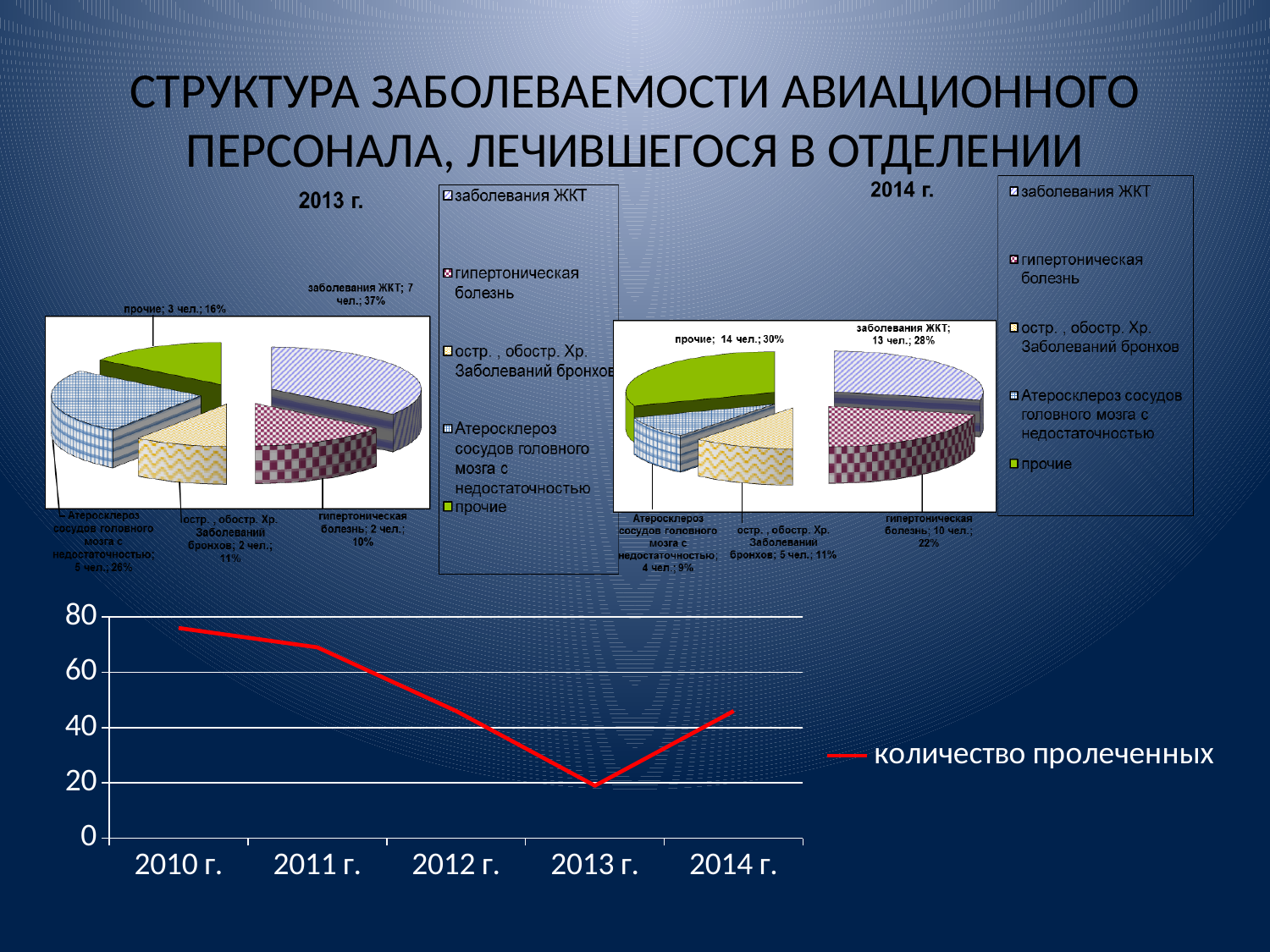
In the bottom line chart, which year has the lowest value? 2013 г. In the 2013 г. pie chart, what is the value shown for заболевания ЖКТ? 7 чел.; 37% In the 2013 г. pie chart, which category has the largest share? заболевания ЖКТ What type of chart is the bottom chart showing количество пролеченных? line chart How many categories does the legend of the 2014 г. pie chart list? 5 In the 2014 г. pie chart, how many more people are in заболевания ЖКТ than in остр., обостр. Хр. Заболеваний бронхов? 8 чел. In the bottom line chart, is the value for 2010 г. greater or less than 60? greater In the 2013 г. pie chart, what share does прочие have? 16% In the 2014 г. pie chart, how many people are shown for гипертоническая болезнь? 10 чел. In the 2014 г. pie chart, which category has the smallest share? Атеросклероз сосудов головного мозга с недостаточностью In the 2014 г. pie chart, what share does прочие have? 30% In the 2013 г. pie chart, how many people are shown for Атеросклероз сосудов головного мозга с недостаточностью? 5 чел.